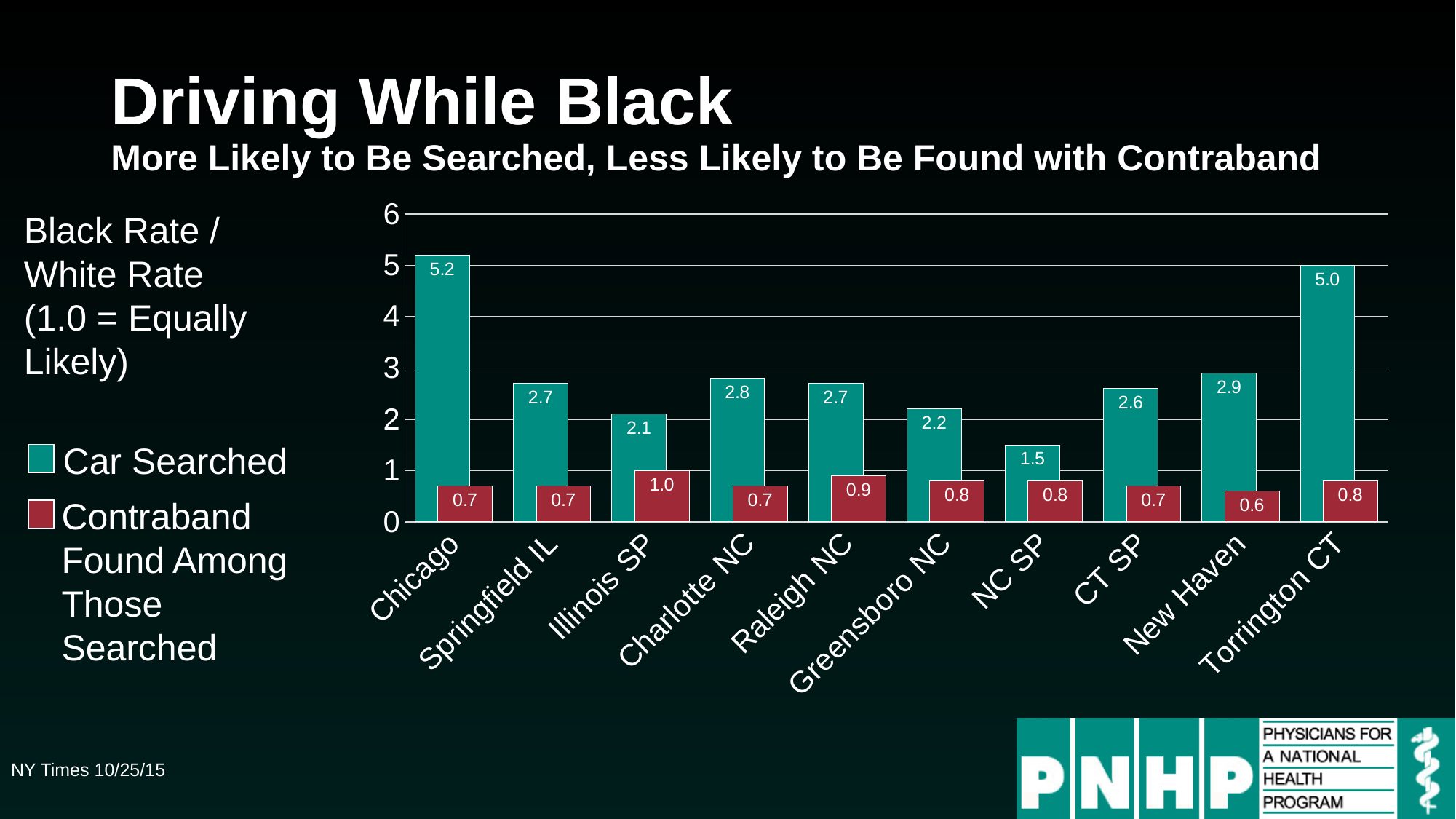
What is the Car Searched value for Chicago? 5.2 Which category has the lowest Contraband Found Among Those Searched value? New Haven What is the Car Searched value for New Haven? 2.9 Which is larger, the Car Searched value for Charlotte NC or for Raleigh NC? Charlotte NC What colour are the Car Searched bars? teal How many series does the legend list? 2 Which category has the highest Car Searched value? Chicago What is the difference between the Car Searched values for Chicago and Torrington CT? 0.2 Which category has the lowest Car Searched value? NC SP How many categories are shown on the x axis? 10 What is the Contraband Found Among Those Searched value for Illinois SP? 1.0 What kind of chart is shown on the slide? bar chart